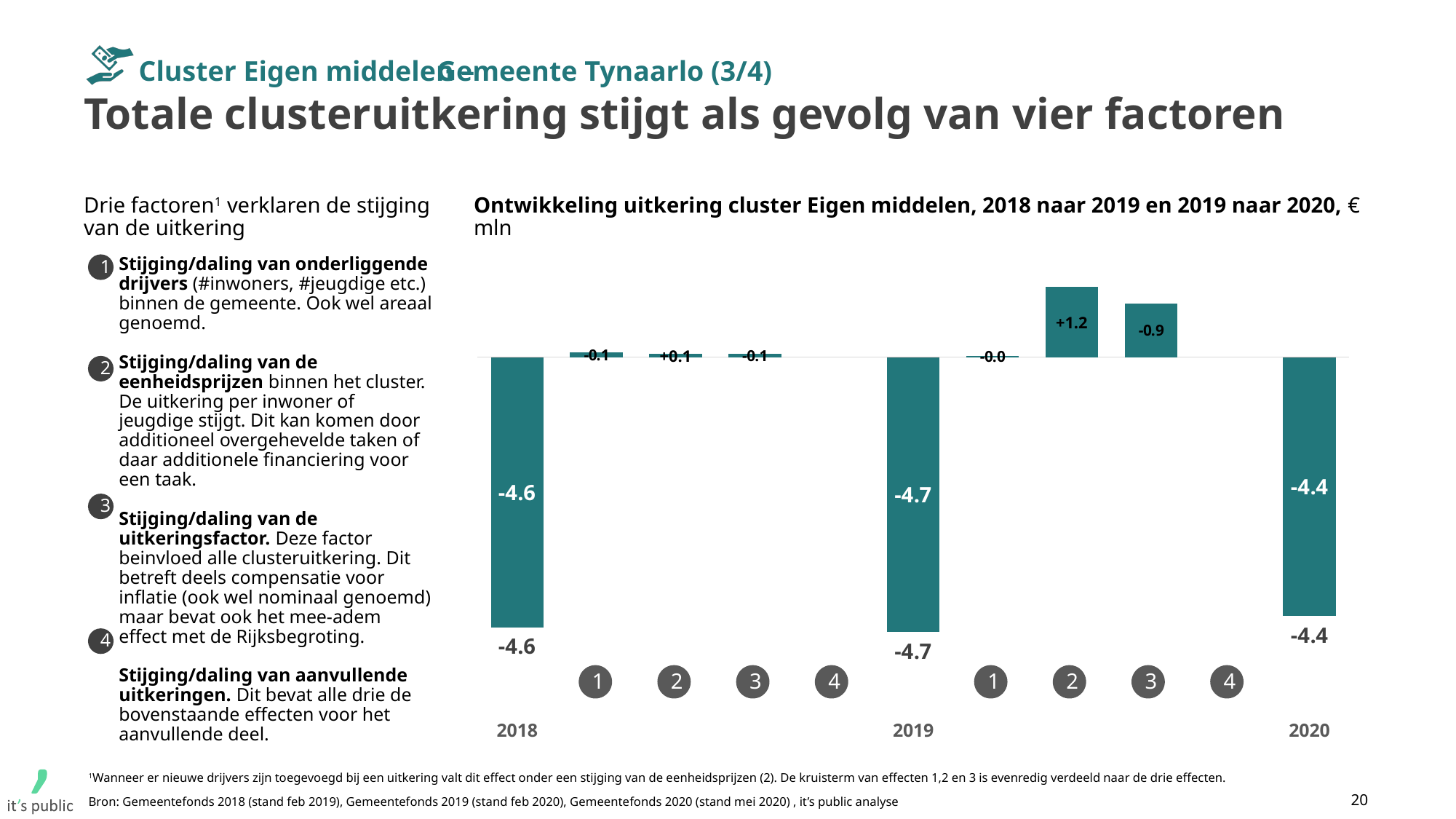
What is the difference between the 2020 total (-4.4) and the 2018 total (-4.6)? 0.2 What is the value of factor 3 (uitkeringsfactor) in the change from 2019 to 2020? -0.9 What kind of chart is shown on the slide? Bar chart (waterfall) Which factor bar has the largest positive value in the chart? Factor 2 in 2019 to 2020 (+1.2) What is the value of factor 2 (eenheidsprijzen) in the change from 2019 to 2020? +1.2 What is the value of the total uitkering for 2018 in the chart? -4.6 Which is larger, the total for 2019 or the total for 2020? 2020 What is the title of the chart? Ontwikkeling uitkering cluster Eigen middelen, 2018 naar 2019 en 2019 naar 2020, € mln What is the value of the total uitkering for 2019 in the chart? -4.7 What is the value of the total uitkering for 2020 in the chart? -4.4 How many year totals (2018, 2019, 2020) are shown as large bars in the chart? 3 What is the value of factor 2 (eenheidsprijzen) in the change from 2018 to 2019? +0.1